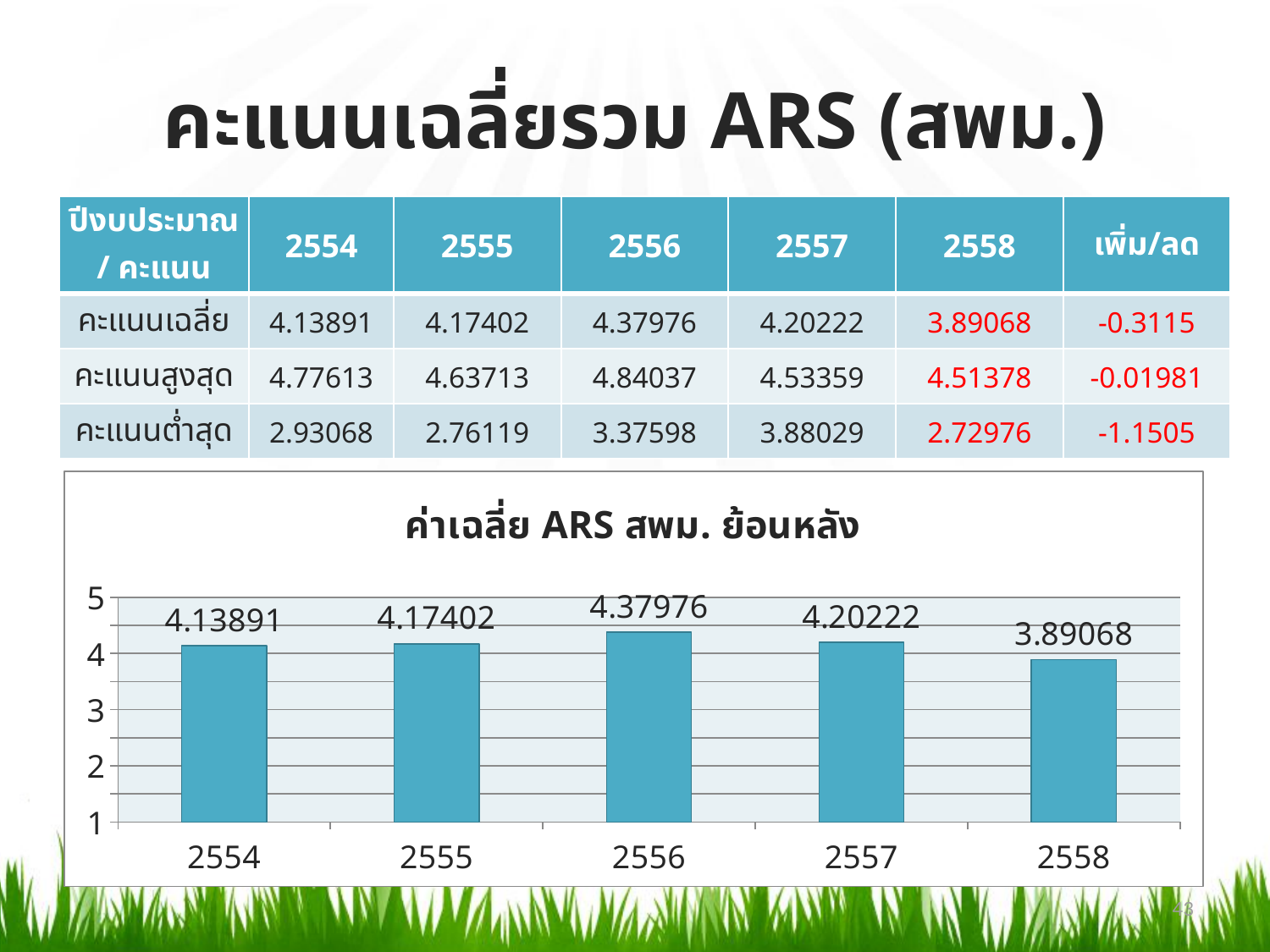
Which year has the highest value in the chart? 2556 How many years are shown on the x axis of the chart? 5 Which year has the lowest value in the chart? 2558 What is the value for 2554 in the chart? 4.13891 What is the difference between the values for 2556 and 2558? 0.48908 What is the title of the chart? ค่าเฉลี่ย ARS สพม. ย้อนหลัง Is the value for 2558 greater or less than 4? less What kind of chart is shown on the slide? bar chart What is the value for 2558 in the chart? 3.89068 What is the value for 2556 in the chart? 4.37976 Which is larger, the value for 2555 or the value for 2557? 2557 Does the value rise or fall from 2557 to 2558? fall